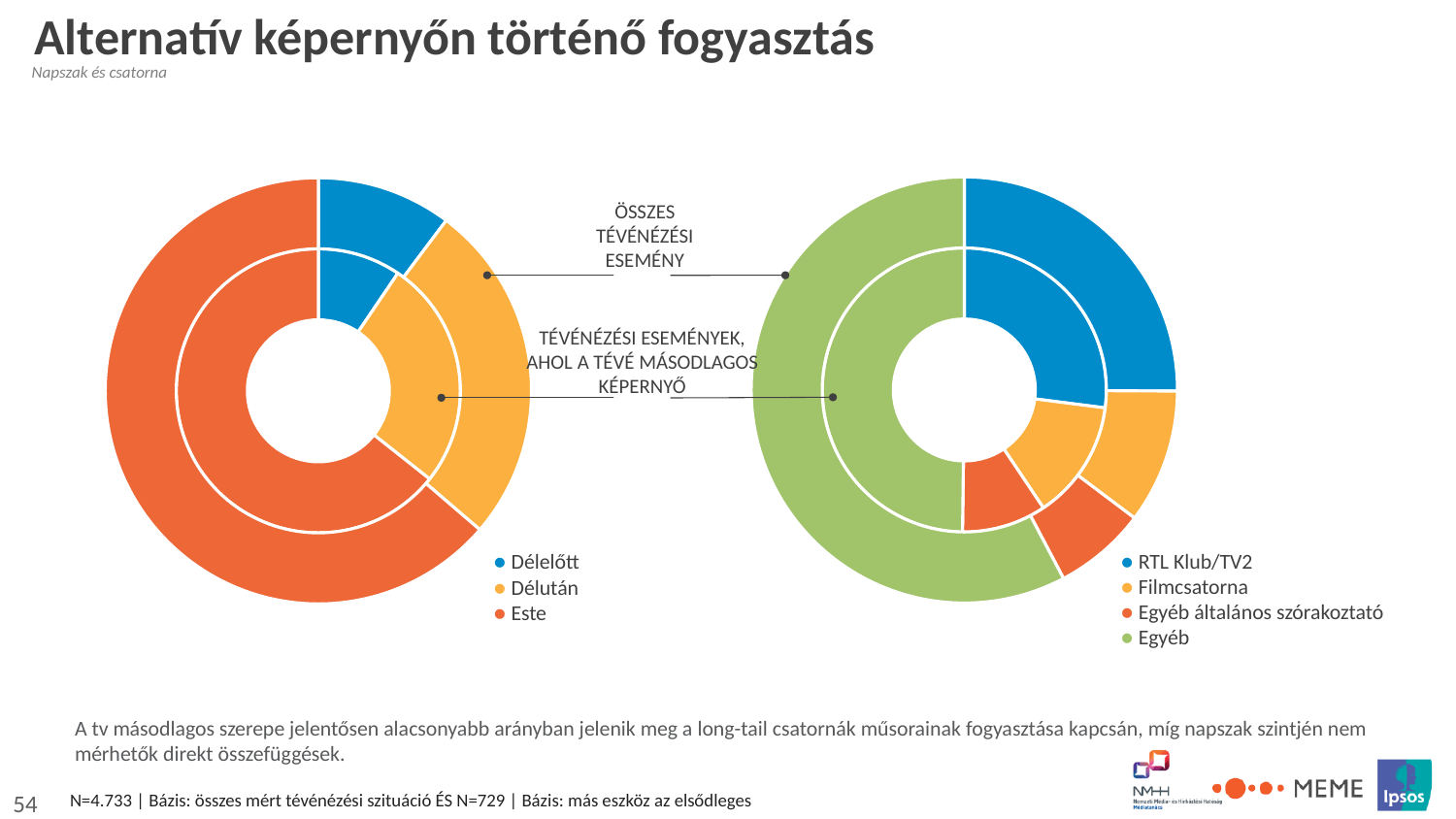
What type of chart is the right chart on the slide? Doughnut chart In the left chart (napszak), which has the larger share in the inner ring: Délután or Délelőtt? Délután In the left chart (napszak), which category has the largest share in the inner ring? Este In the left chart (napszak), which category has the largest share in the outer ring? Este In the left chart (napszak), which category has the smallest share in the outer ring? Délelőtt In the right chart (csatorna), which category has the largest share in the outer ring? Egyéb What type of chart is the left chart on the slide? Doughnut chart How many categories does the legend of the right chart list? 4 How many categories does the legend of the left chart list? 3 In the right chart (csatorna), which has the larger share in the outer ring: RTL Klub/TV2 or Filmcsatorna? RTL Klub/TV2 What does the inner ring of each chart represent, according to the labels on the slide? Tévénézési események, ahol a tévé másodlagos képernyő